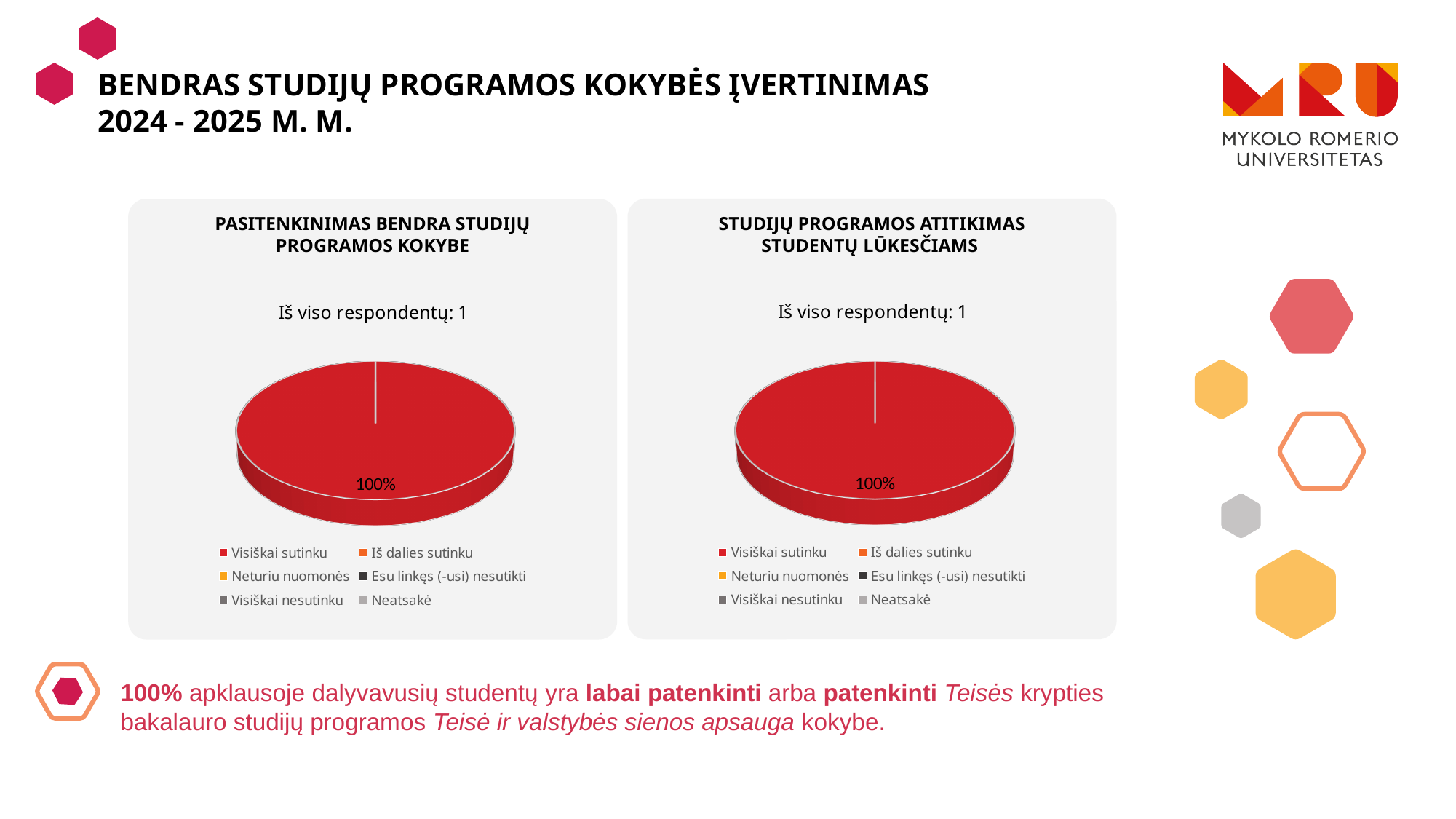
What kind of chart is shown under the title "Pasitenkinimas bendra studijų programos kokybe"? Pie chart In the left chart ("Pasitenkinimas bendra studijų programos kokybe"), which legend entry is shown in yellow? Neturiu nuomonės What is the title of the chart on the right side of the slide? Studijų programos atitikimas studentų lūkesčiams In the left chart ("Pasitenkinimas bendra studijų programos kokybe"), what share of the pie does "Visiškai sutinku" take? 100% How many respondents are reported for the left chart ("Pasitenkinimas bendra studijų programos kokybe")? 1 In the left chart ("Pasitenkinimas bendra studijų programos kokybe"), which category has the largest share? Visiškai sutinku How many pie charts are shown on the slide? 2 How many entries does the legend of the left chart ("Pasitenkinimas bendra studijų programos kokybe") list? 6 In the right chart ("Studijų programos atitikimas studentų lūkesčiams"), which category has the largest share? Visiškai sutinku In the right chart ("Studijų programos atitikimas studentų lūkesčiams"), what share of the pie does "Visiškai sutinku" take? 100% How many respondents are reported for the right chart ("Studijų programos atitikimas studentų lūkesčiams")? 1 How many entries does the legend of the right chart ("Studijų programos atitikimas studentų lūkesčiams") list? 6